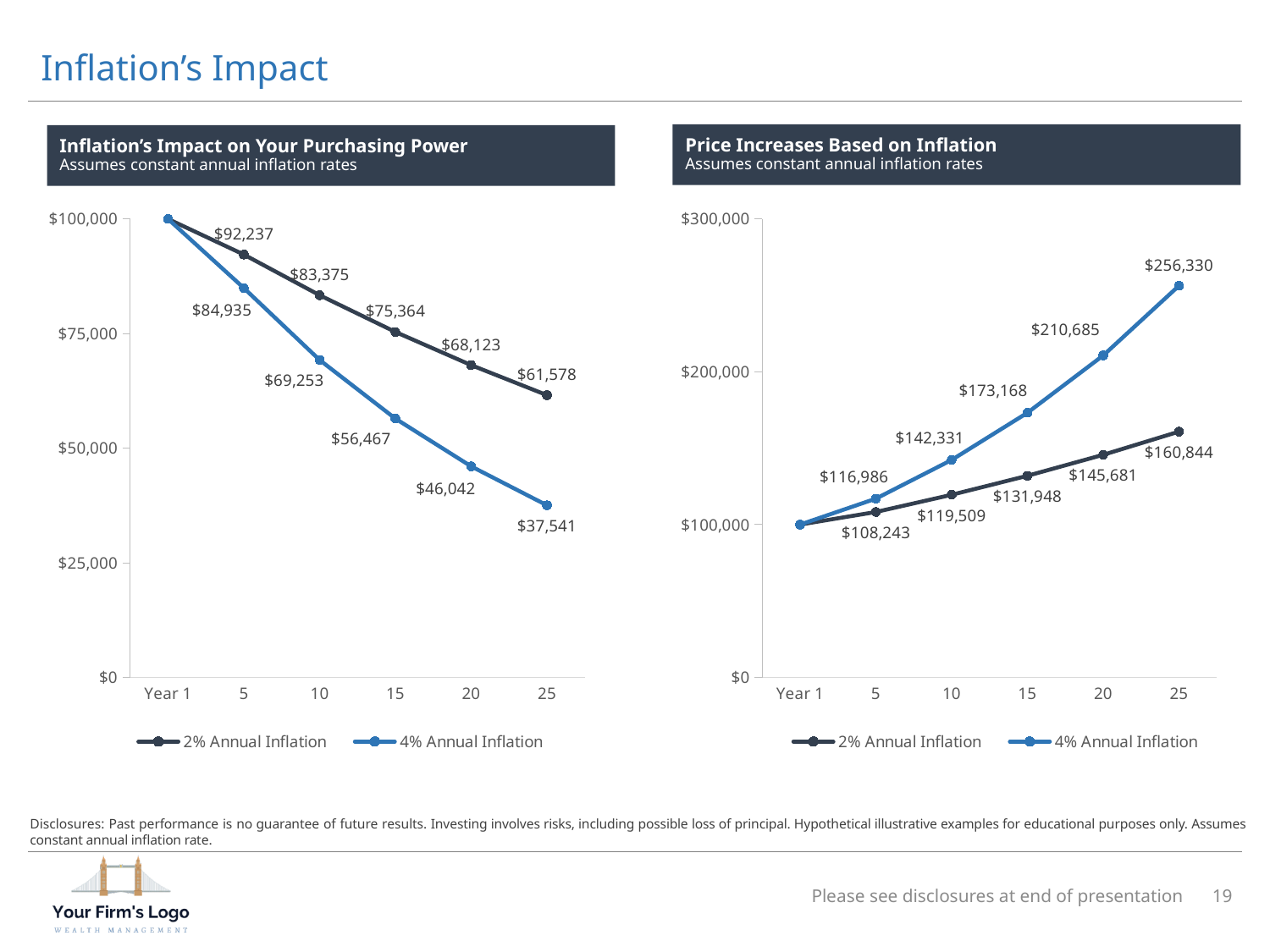
In the 'Price Increases Based on Inflation' chart, is the value for 4% Annual Inflation at year 20 greater or less than $200,000? greater In the 'Inflation's Impact on Your Purchasing Power' chart, which series has the lower value at year 15? 4% Annual Inflation What type of chart is the 'Inflation's Impact on Your Purchasing Power' chart? line chart In the 'Inflation's Impact on Your Purchasing Power' chart, what is the value for 4% Annual Inflation at year 10? $69,253 In the 'Inflation's Impact on Your Purchasing Power' chart, do the values rise or fall as the years increase? fall In the 'Price Increases Based on Inflation' chart, what is the difference between the 4% and 2% Annual Inflation values at year 20? $65,004 In the 'Inflation's Impact on Your Purchasing Power' chart, what is the value for 2% Annual Inflation at year 25? $61,578 In the 'Price Increases Based on Inflation' chart, what is the value for 2% Annual Inflation at year 15? $131,948 In the 'Price Increases Based on Inflation' chart, do the values rise or fall as the years increase? rise In the 'Price Increases Based on Inflation' chart, what is the value for 4% Annual Inflation at year 25? $256,330 How many series does the legend of the 'Price Increases Based on Inflation' chart list? 2 In the 'Inflation's Impact on Your Purchasing Power' chart, what is the difference between the 2% and 4% Annual Inflation values at year 25? $24,037